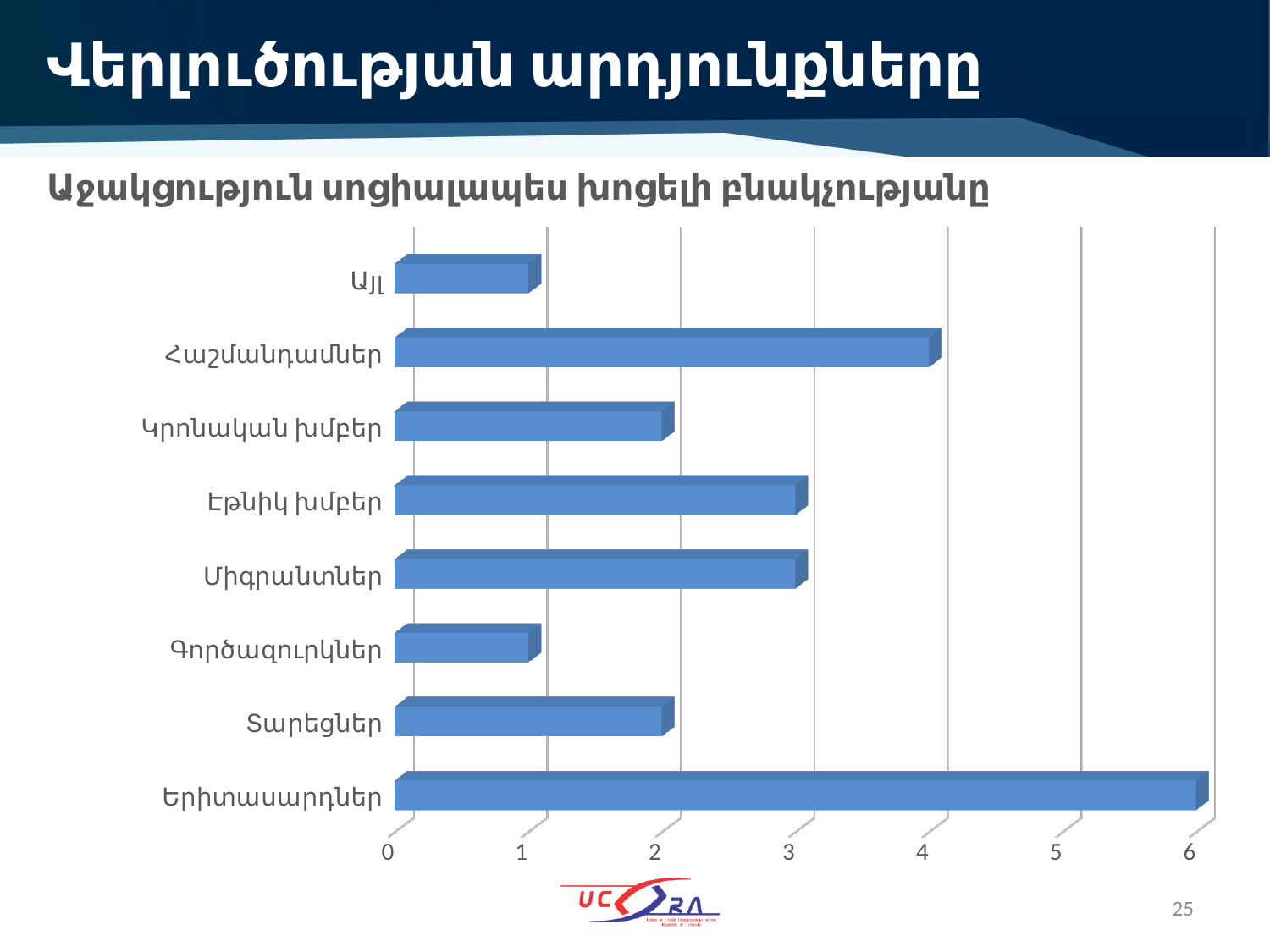
What type of chart is shown on the slide? Bar chart What is the value for Տարեցներ? 2 Which category has the highest value? Երիտասարդներ Is the value for Երիտասարդներ greater or less than 5? greater Is the value for Գործազուրկներ greater or less than 2? less Which is larger, the value for Հաշմանդամներ or the value for Կրոնական խմբեր? Հաշմանդամներ What is the title of the chart? Աջակցություն սոցիալապես խոցելի բնակչությանը What is the value for Երիտասարդներ? 6 What is the value for Էթնիկ խմբեր? 3 What is the difference between the values for Երիտասարդներ and Հաշմանդամներ? 2 What is the value for Հաշմանդամներ? 4 How many categories are shown in the chart? 8